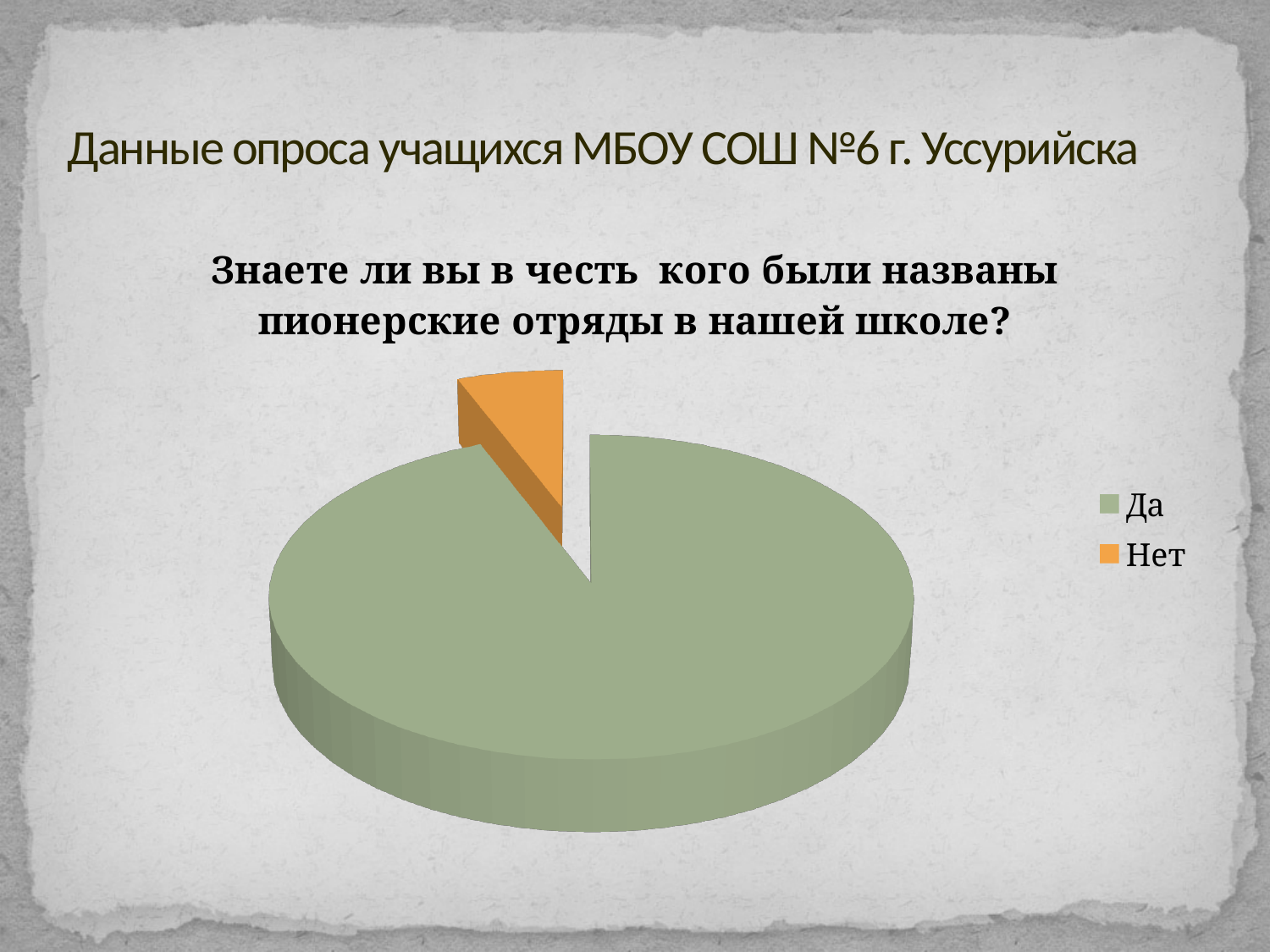
Which category has the smallest slice in the pie chart? Нет Which category has the largest slice in the pie chart? Да How many slices does the pie chart have? 2 What is the title of the pie chart? Знаете ли вы в честь кого были названы пионерские отряды в нашей школе? What colour is the Нет slice in the pie chart? orange What kind of chart is shown on the slide? pie chart How many entries does the legend of the pie chart list? 2 Which slice is larger in the pie chart, Да or Нет? Да